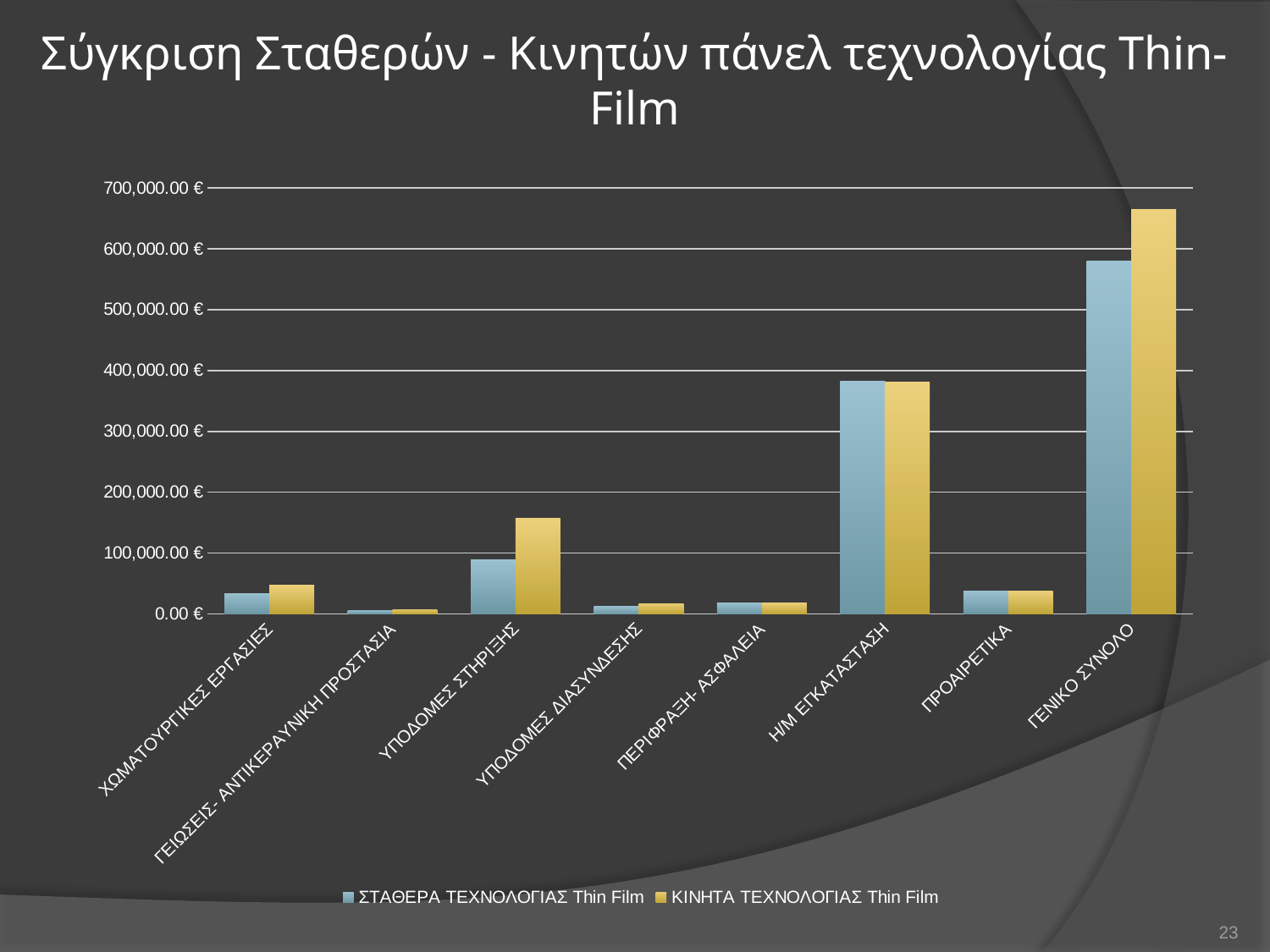
What colour are the bars for the ΚΙΝΗΤΑ ΤΕΧΝΟΛΟΓΙΑΣ Thin Film series? yellow How many series does the legend list? 2 What kind of chart is shown on the slide? bar chart For ΥΠΟΔΟΜΕΣ ΣΤΗΡΙΞΗΣ, which series has the larger value? ΚΙΝΗΤΑ ΤΕΧΝΟΛΟΓΙΑΣ Thin Film Which category has the highest value for ΚΙΝΗΤΑ ΤΕΧΝΟΛΟΓΙΑΣ Thin Film? ΓΕΝΙΚΟ ΣΥΝΟΛΟ How many categories are shown on the x axis? 8 Is the value for ΓΕΝΙΚΟ ΣΥΝΟΛΟ in the ΣΤΑΘΕΡΑ ΤΕΧΝΟΛΟΓΙΑΣ Thin Film series greater or less than 600,000.00 €? less Which category has the lowest value for ΣΤΑΘΕΡΑ ΤΕΧΝΟΛΟΓΙΑΣ Thin Film? ΓΕΙΩΣΕΙΣ- ΑΝΤΙΚΕΡΑΥΝΙΚΗ ΠΡΟΣΤΑΣΙΑ Is the value for Η/Μ ΕΓΚΑΤΑΣΤΑΣΗ in the ΣΤΑΘΕΡΑ ΤΕΧΝΟΛΟΓΙΑΣ Thin Film series greater or less than 400,000.00 €? less Is the value for ΥΠΟΔΟΜΕΣ ΣΤΗΡΙΞΗΣ in the ΚΙΝΗΤΑ ΤΕΧΝΟΛΟΓΙΑΣ Thin Film series greater or less than 100,000.00 €? greater For ΓΕΝΙΚΟ ΣΥΝΟΛΟ, which series has the larger value? ΚΙΝΗΤΑ ΤΕΧΝΟΛΟΓΙΑΣ Thin Film